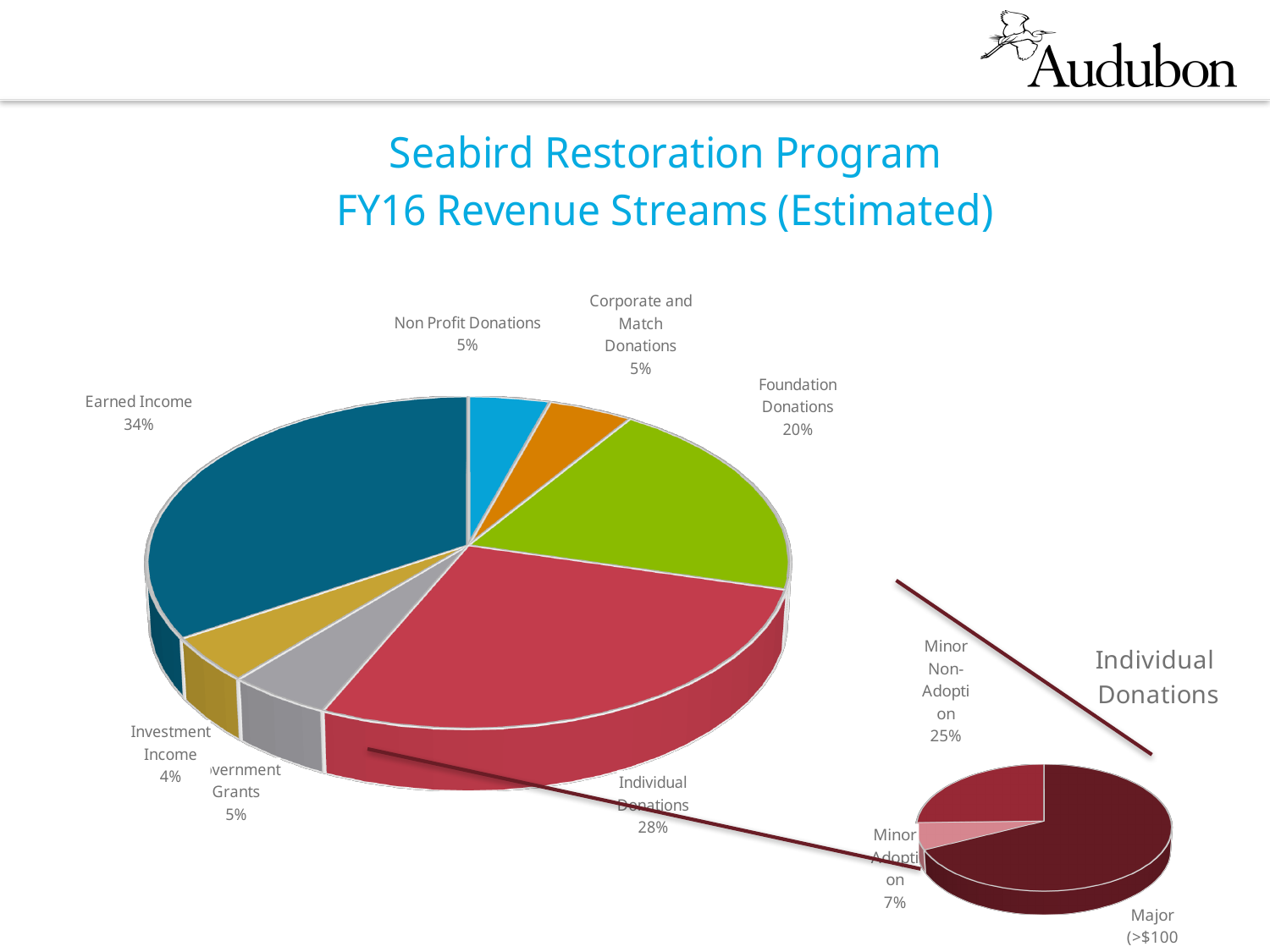
In the main pie chart, which revenue stream has the smallest share? Investment Income In the main pie chart, which revenue stream has the largest share? Earned Income In the smaller Individual Donations pie chart, what share is Minor Non-Adoption? 25% In the main pie chart, what share of FY16 revenue is Individual Donations? 28% In the main pie chart, what share of FY16 revenue is Foundation Donations? 20% In the main pie chart, what share of FY16 revenue is Investment Income? 4% How many slices does the main pie chart have? 7 What type of chart is the main chart on the slide? Pie chart In the main pie chart, what is the difference in percentage points between Earned Income and Individual Donations? 6 percentage points In the main pie chart, what share of FY16 revenue is Earned Income? 34% In the main pie chart, which is larger: Foundation Donations or Individual Donations? Individual Donations In the smaller Individual Donations pie chart, what share is Minor Adoption? 7%